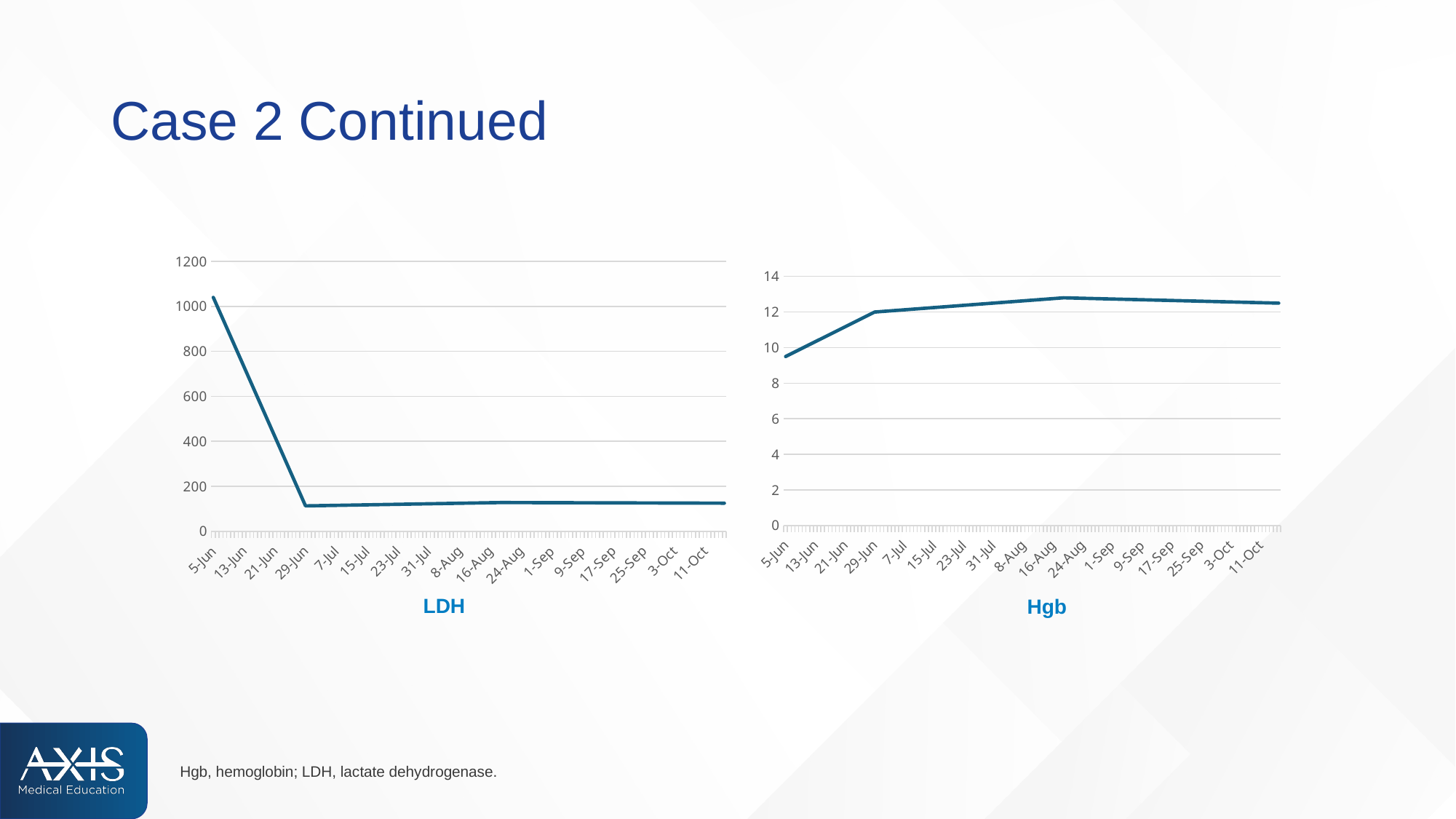
In the LDH chart, on which date is the value highest? 5-Jun In the Hgb chart, is the value on 5-Jun greater or less than 10? less What kind of chart is the LDH chart? line chart In the LDH chart, is the value on 29-Jun greater or less than 200? less In the Hgb chart, on which date is the value lowest? 5-Jun In the LDH chart, is the value on 5-Jun greater or less than 800? greater In the Hgb chart, do the values rise or fall between 5-Jun and 16-Aug? rise What is the title of the chart on the right side of the slide? Hgb In the Hgb chart, which is larger, the value on 5-Jun or the value on 29-Jun? 29-Jun In the LDH chart, do the values rise or fall between 5-Jun and 29-Jun? fall What kind of chart is the Hgb chart? line chart